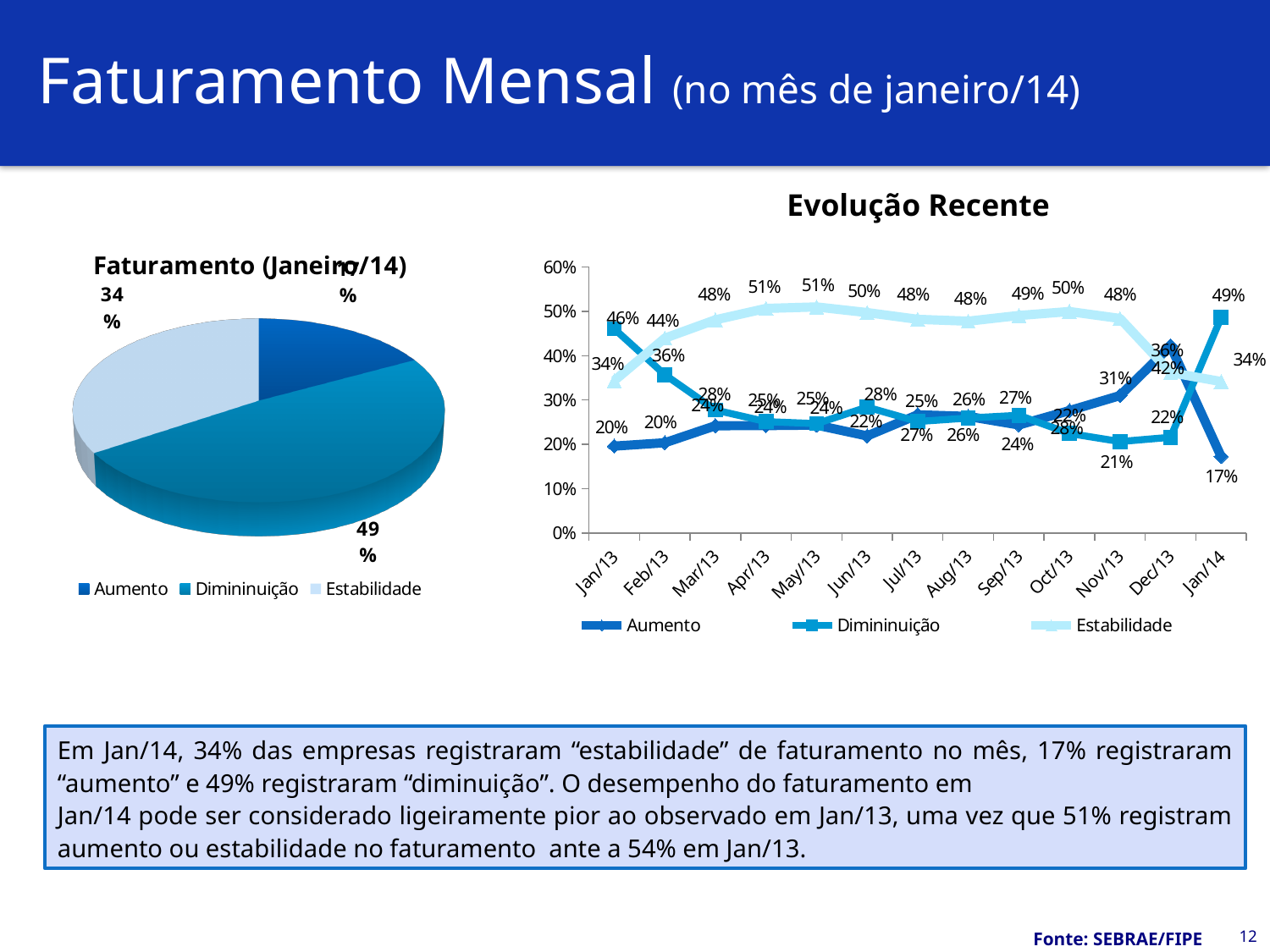
In the 'Evolução Recente' chart, which is larger in Jan/14: Diminuição or Estabilidade? Diminuição In the 'Faturamento (Janeiro/14)' pie chart, what share is labelled for Estabilidade? 34% In the 'Evolução Recente' chart, by how many percentage points did Diminuição fall from Jan/13 to Feb/13? 10 percentage points How many months are plotted along the x axis of the 'Evolução Recente' chart? 13 In the 'Evolução Recente' chart, what is the value of Diminuição in Nov/13? 21% How many series does the legend of the 'Evolução Recente' chart list? 3 In the 'Faturamento (Janeiro/14)' pie chart, what share is labelled for Diminuição? 49% What kind of chart is the 'Faturamento (Janeiro/14)' chart on the left? Pie chart What kind of chart is the 'Evolução Recente' chart on the right? Line chart In the 'Evolução Recente' chart, what is the value of Aumento in Nov/13? 31% In the 'Evolução Recente' chart, what is the value of Diminuição in Jan/13? 46% In the 'Evolução Recente' chart, in which month is Aumento at its lowest? Jan/14